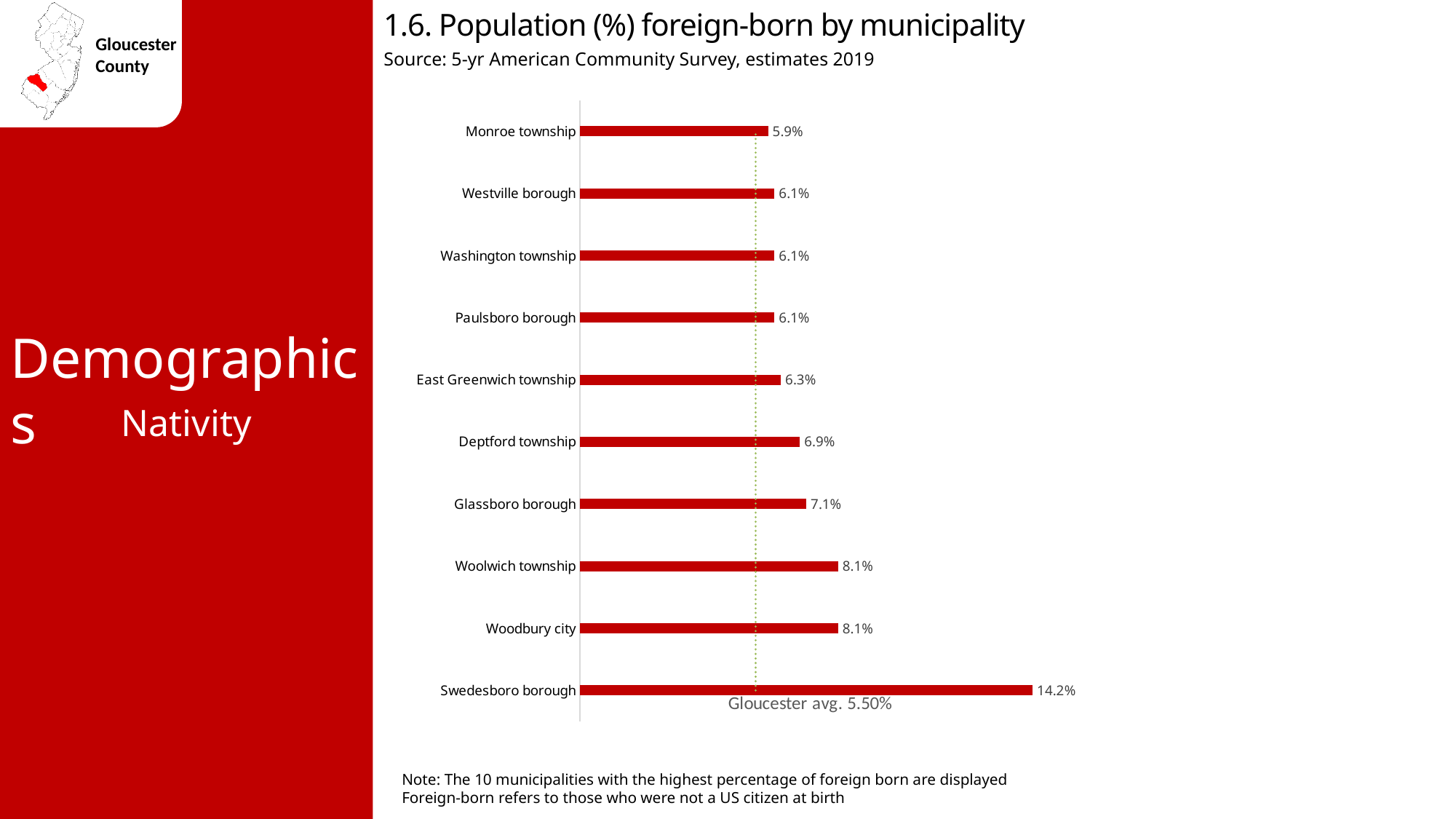
What is the difference between the foreign-born percentages of Glassboro borough and East Greenwich township? 0.8% What is the Gloucester County average foreign-born percentage marked on the chart? 5.50% What is the difference between the foreign-born percentages of Swedesboro borough and Woodbury city? 6.1% Which municipality has the lowest percentage of foreign-born population on the chart? Monroe township How many municipalities are shown on the chart? 10 What is the source of the data shown in the chart? 5-yr American Community Survey, estimates 2019 Which has a higher foreign-born percentage, Woolwich township or Deptford township? Woolwich township What is the foreign-born population percentage for Swedesboro borough? 14.2% Which municipality has the highest percentage of foreign-born population? Swedesboro borough What is the foreign-born population percentage for Deptford township? 6.9% What kind of chart is used on this slide? Bar chart What is the foreign-born population percentage for Monroe township? 5.9%